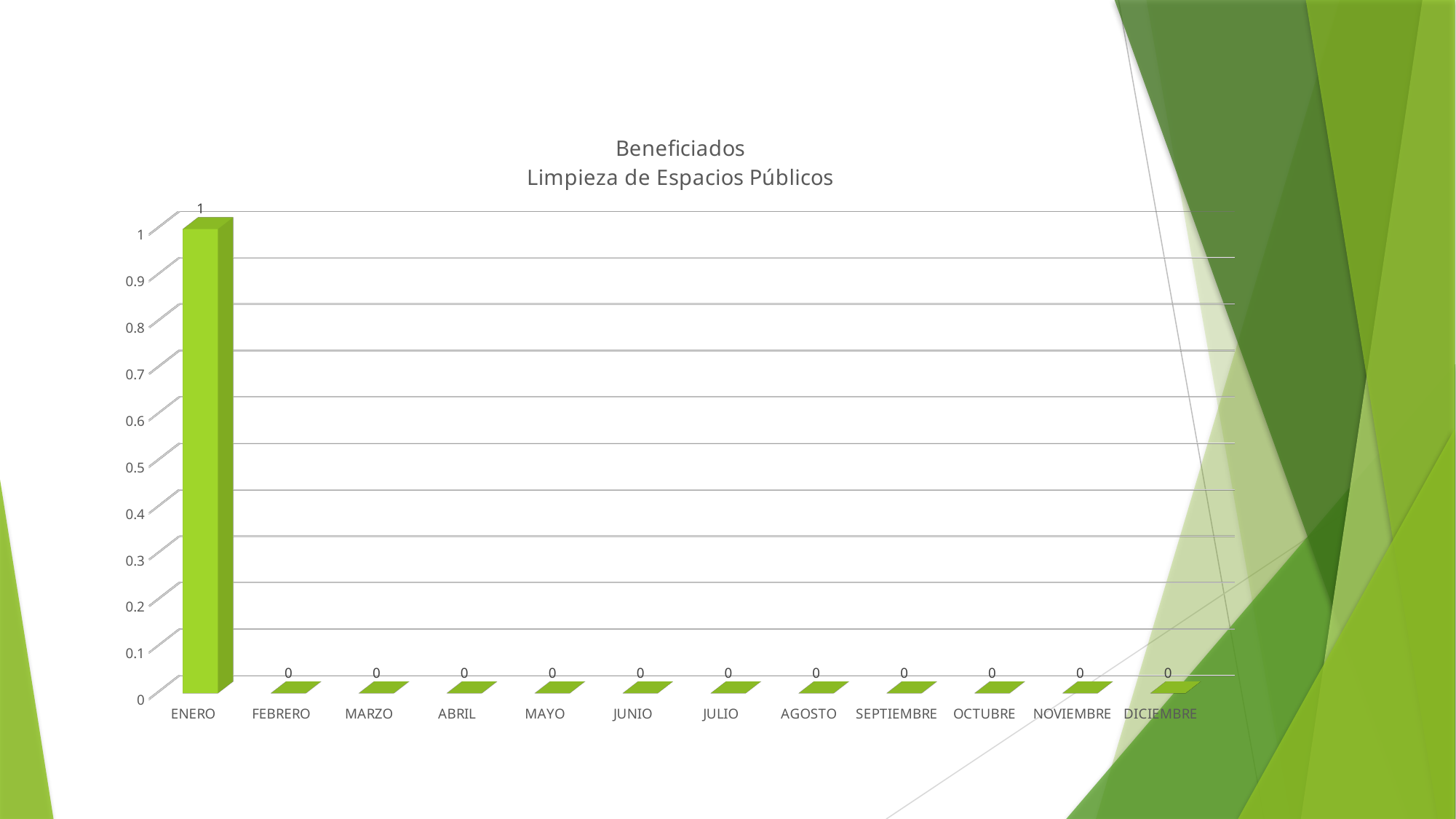
What is the total of all the values shown in the chart? 1 What is the title of the chart? Beneficiados Limpieza de Espacios Públicos What kind of chart is shown? bar chart Which month has the highest value? ENERO What is the value for ENERO? 1 What is the highest value shown on the y axis? 1 What is the difference between the values for ENERO and FEBRERO? 1 What is the value for JULIO? 0 What is the value for DICIEMBRE? 0 How many months have a value of 0? 11 Which is larger, the value for ENERO or the value for MAYO? ENERO How many months are shown on the x axis? 12